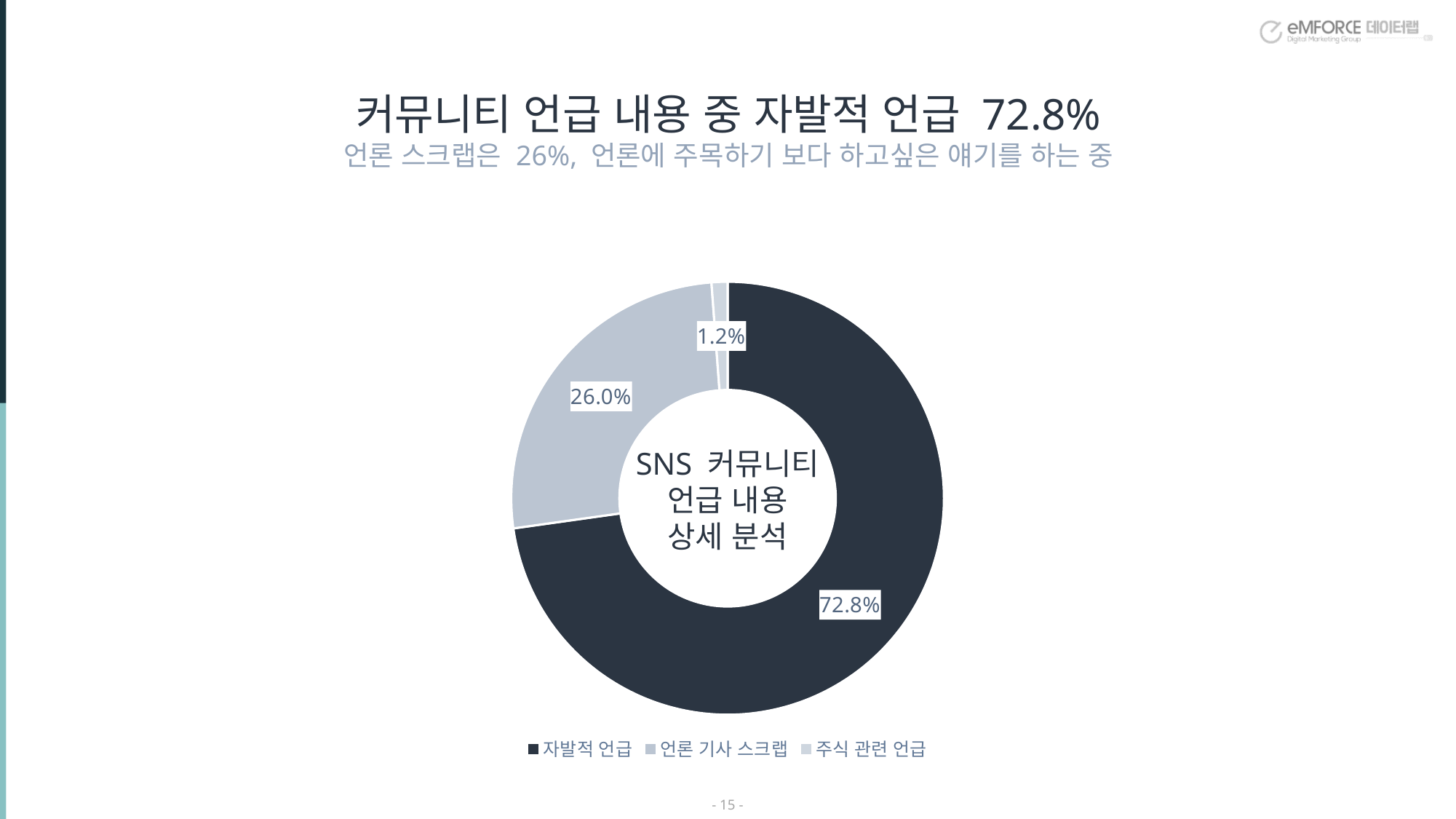
What share of the chart does 주식 관련 언급 account for? 1.2% How many categories does the chart show? 3 What share of the chart does 자발적 언급 account for? 72.8% Which is larger, the share for 언론 기사 스크랩 or the share for 주식 관련 언급? 언론 기사 스크랩 Which category is shown in the dark navy colour? 자발적 언급 What is the difference in percentage points between 자발적 언급 and 언론 기사 스크랩? 46.8 percentage points What is the text shown in the centre of the donut chart? SNS 커뮤니티 언급 내용 상세 분석 What kind of chart is shown on the slide? Donut (pie) chart Which category has the largest share of the chart? 자발적 언급 What share of the chart does 언론 기사 스크랩 account for? 26.0% How many entries does the legend list? 3 Which category has the smallest share of the chart? 주식 관련 언급